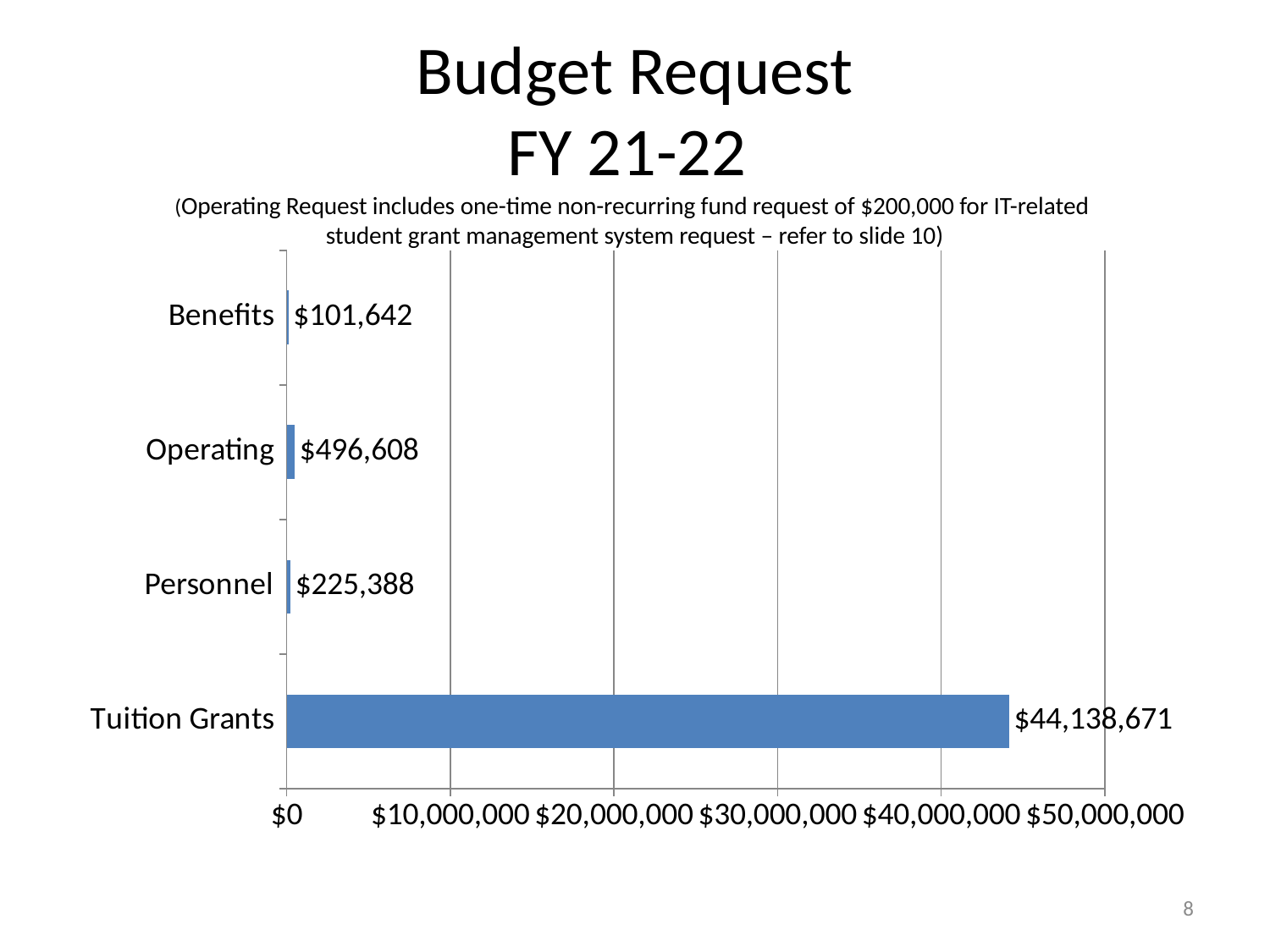
What is the value for Tuition Grants? $44,138,671 How many categories are shown in the chart? 4 Which category has the lowest value? Benefits Is the value for Tuition Grants greater or less than $40,000,000? greater Which category has the highest value? Tuition Grants What kind of chart is shown on the slide? bar chart What is the value for Personnel? $225,388 What is the difference between the Operating and Benefits values? $394,966 What is the value for Operating? $496,608 What is the difference between the Personnel and Benefits values? $123,746 What is the value for Benefits? $101,642 Which is larger, the value for Operating or the value for Personnel? Operating